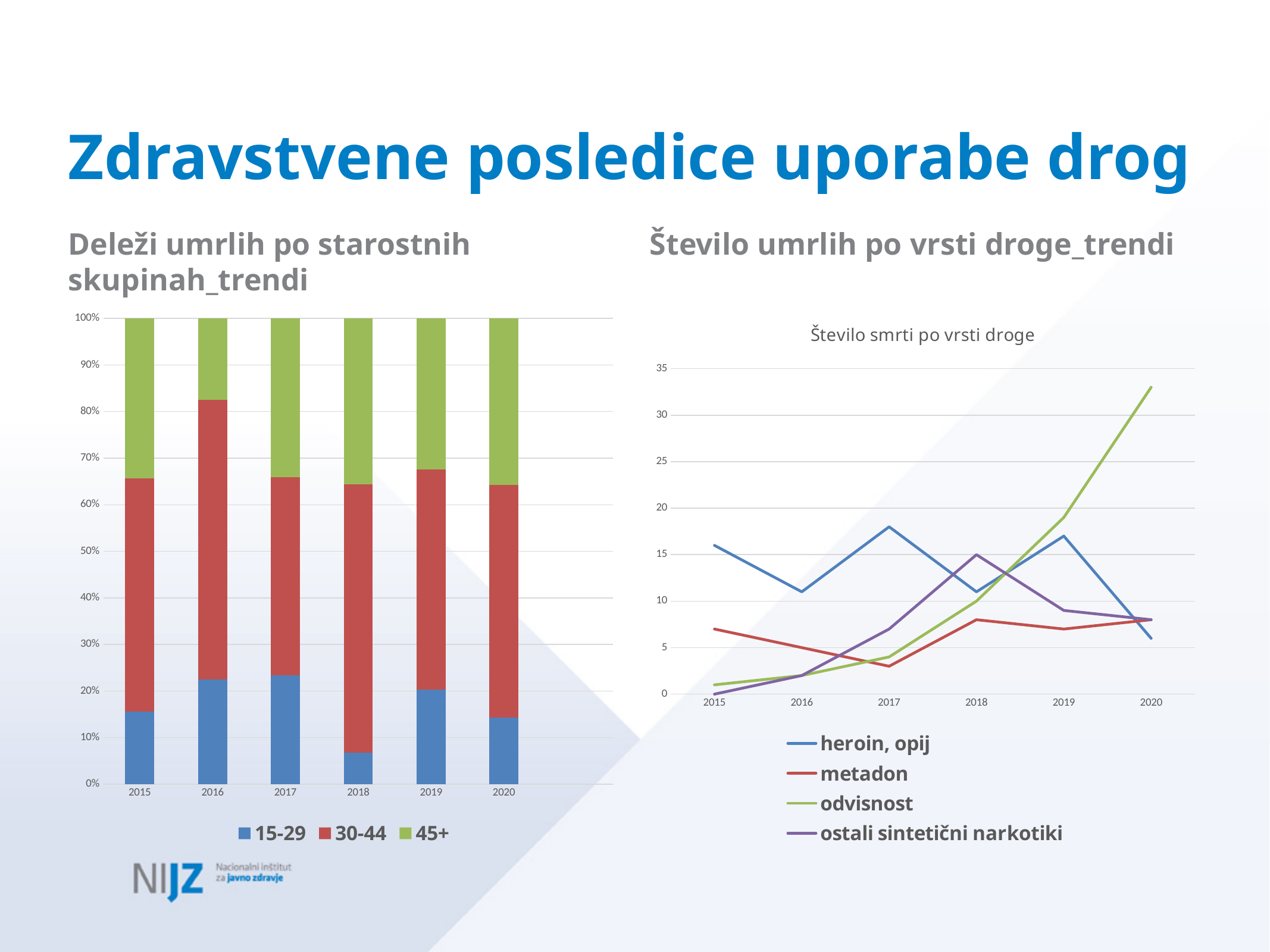
How many series does the legend of the left chart list? 3 In the right chart, which series has the highest value in 2020? odvisnost In the right chart, which series has the highest value in 2015? heroin, opij How many years are shown on the x axis of the left chart? 6 In the right chart, does the odvisnost line rise or fall from 2015 to 2020? rise In the right chart, is the value for odvisnost in 2020 greater or less than 30? greater How many series does the legend of the right chart list? 4 In the right chart, is the value for heroin, opij in 2020 greater or less than 10? less What kind of chart is the right chart, 'Število smrti po vrsti droge'? line chart In the left chart, is the share of the 15-29 group in 2018 greater or less than 10%? less In the right chart, which series has the lowest value in 2015? ostali sintetični narkotiki What kind of chart is the left chart, 'Deleži umrlih po starostnih skupinah_trendi'? bar chart